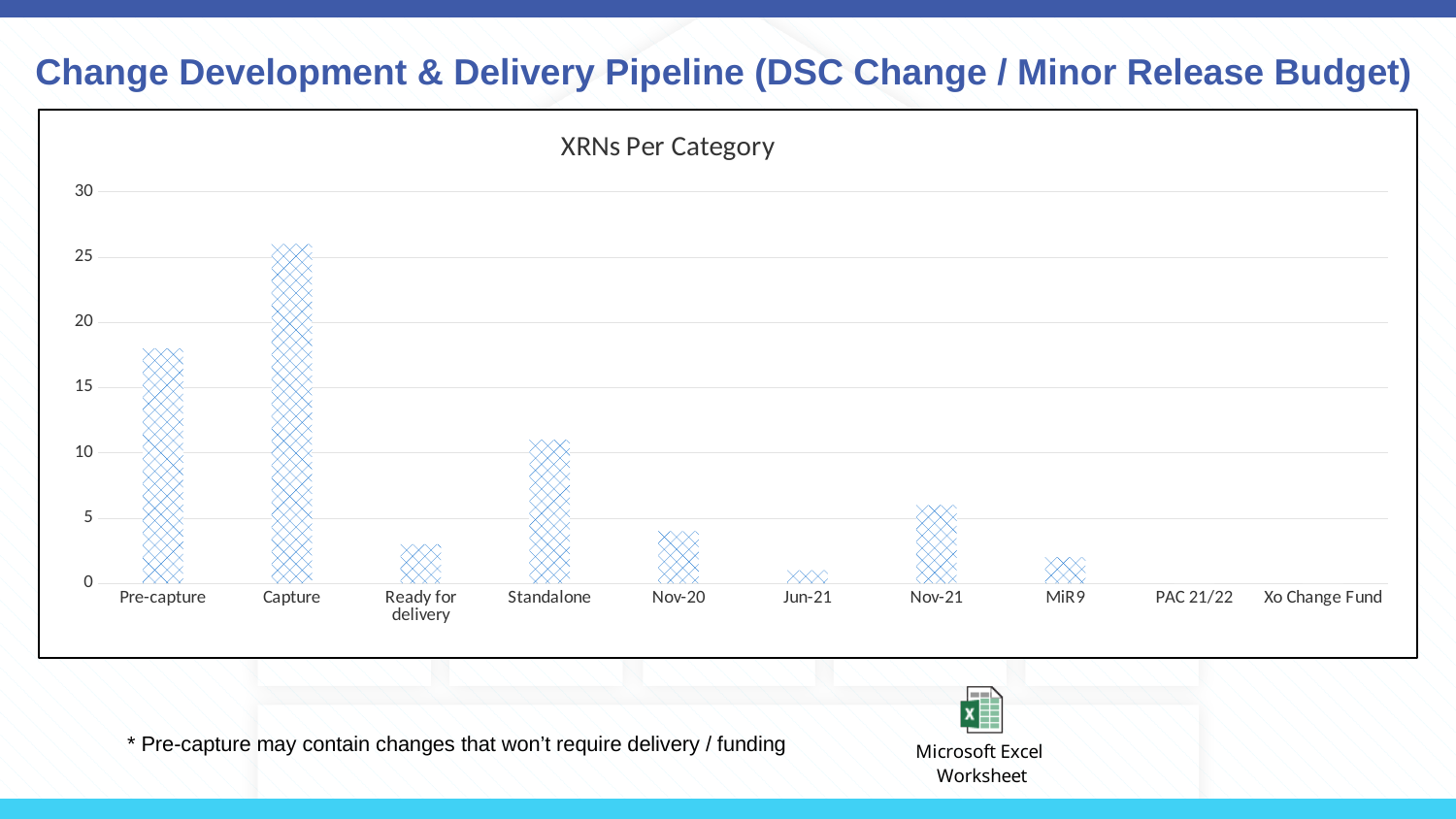
Is the value for Standalone greater or less than 10? greater Is the value for Capture greater or less than 20? greater What kind of chart is shown on the slide? bar chart Is the value for Jun-21 greater or less than 5? less What is the title of the chart? XRNs Per Category Which categories show no bar at all in the chart? PAC 21/22 and Xo Change Fund Which is larger, the value for Pre-capture or the value for Standalone? Pre-capture Which category has the highest value in the chart? Capture Which is larger, the value for Nov-20 or the value for Nov-21? Nov-21 How many categories are shown on the x axis of the chart? 10